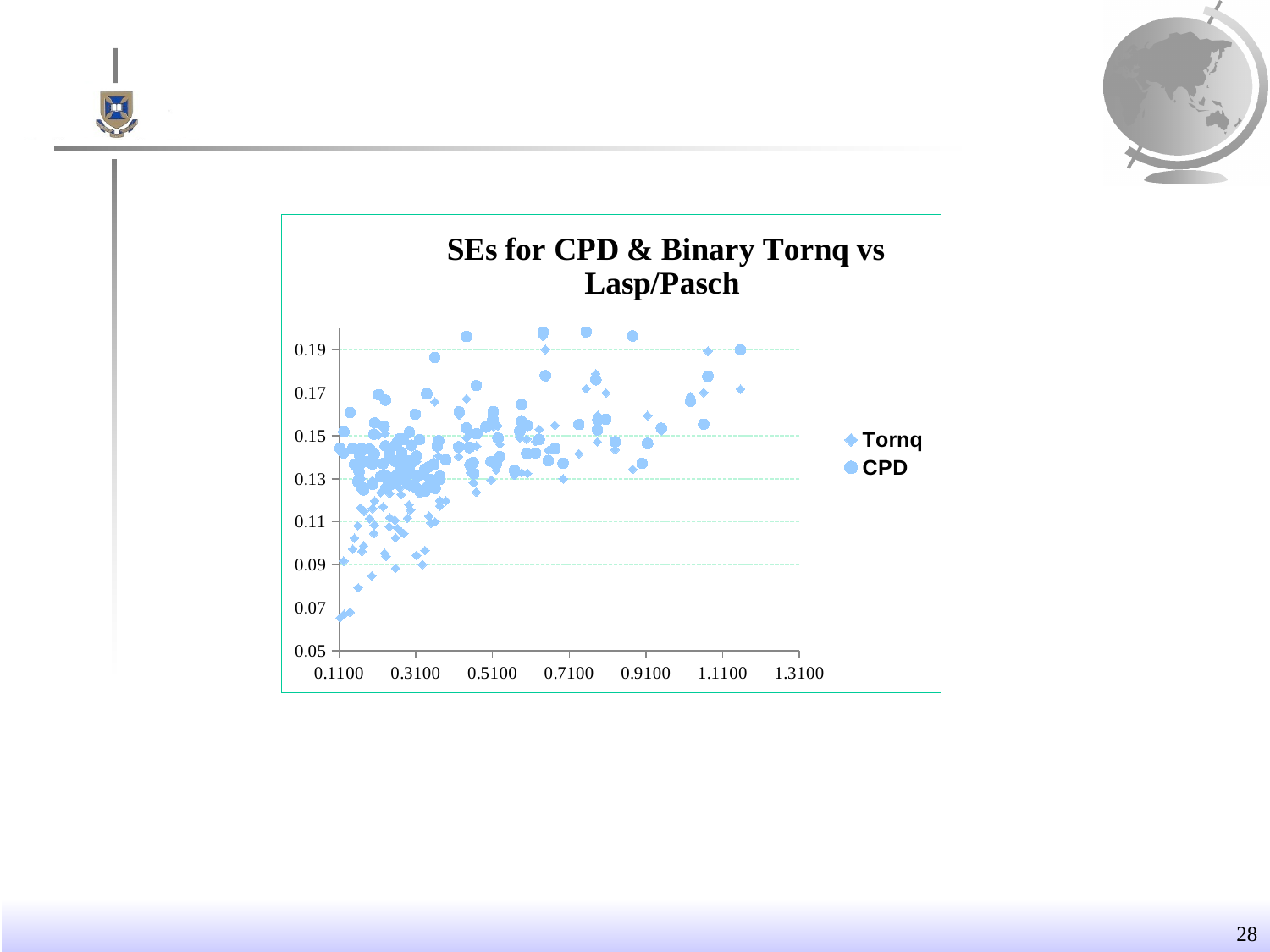
Are the Tornq points near x = 0.1100 mostly greater or less than 0.13? less Which series contains the highest plotted points on the chart? CPD How many series does the legend list? 2 Do the plotted values generally rise or fall as the x-axis value increases? rise What kind of chart is shown on the slide? scatter chart Is the lowest plotted value on the chart greater or less than 0.09? less Which series contains the lowest plotted point on the chart? Tornq Is the highest plotted value on the chart greater or less than 0.17? greater What is the title of the chart? SEs for CPD & Binary Tornq vs Lasp/Pasch What are the two series named in the legend? Tornq and CPD